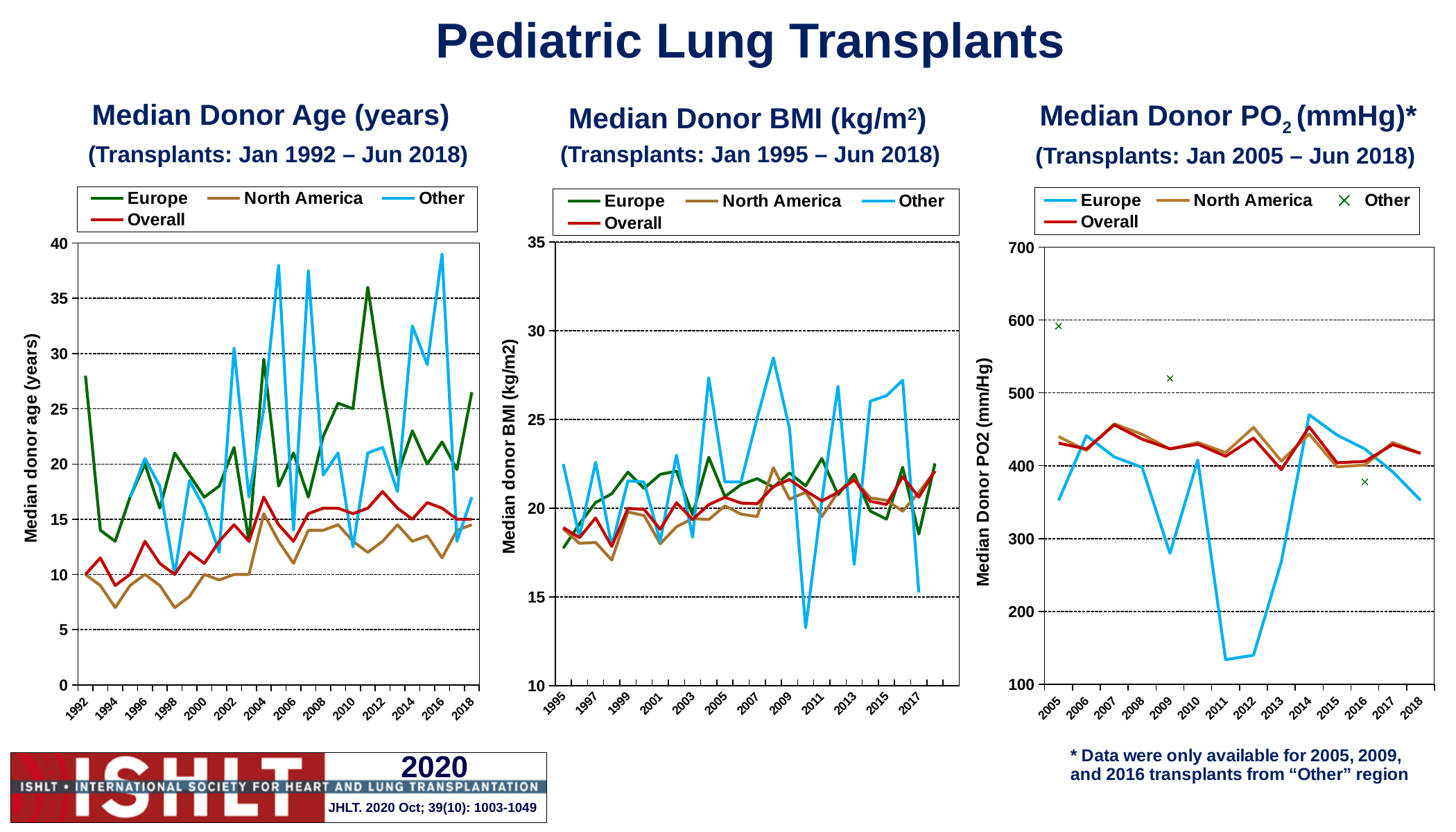
In the Median Donor PO2 (mmHg) chart, how many data points are plotted for the Other series? 3 In the Median Donor BMI (kg/m²) chart, which is larger in 2008, Other or Europe? Other In the Median Donor Age (years) chart, is the value for North America in 1998 greater or less than 10? less In the Median Donor Age (years) chart, which is larger in 2011, Europe or North America? Europe In the Median Donor PO2 (mmHg) chart, which series is shown with green x markers instead of a line? Other In the Median Donor PO2 (mmHg) chart, is the value for Other in 2005 greater or less than 500? greater What kind of chart is the Median Donor Age (years) chart? line chart In the Median Donor Age (years) chart, does the North America line generally rise or fall from 1992 to 2018? rise How many series does the legend of the Median Donor BMI (kg/m²) chart list? 4 In the Median Donor Age (years) chart, is the value for Europe in 1992 greater or less than 25? greater